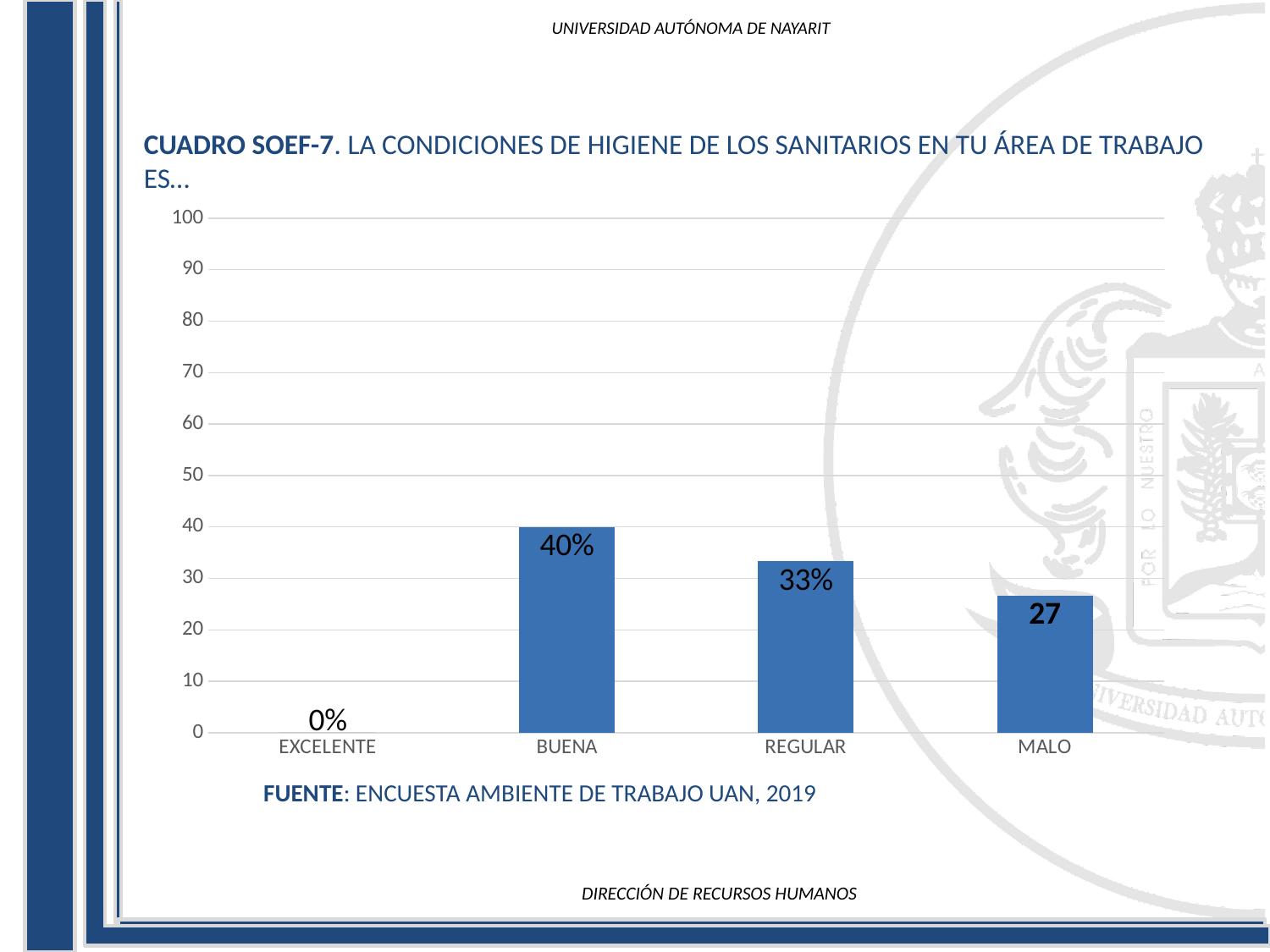
Which is larger, the value for REGULAR or the value for MALO? REGULAR What is the value for REGULAR? 33% Which category has the highest value? BUENA What kind of chart is shown on the slide? bar chart What is the value for BUENA? 40% How many categories are shown on the x axis? 4 What source is cited below the chart? ENCUESTA AMBIENTE DE TRABAJO UAN, 2019 What is the data label shown on the MALO bar? 27 Which category has the lowest value? EXCELENTE What is the value for EXCELENTE? 0% Is the value for BUENA greater or less than 50? less What is the difference between the values for BUENA and REGULAR? 7%